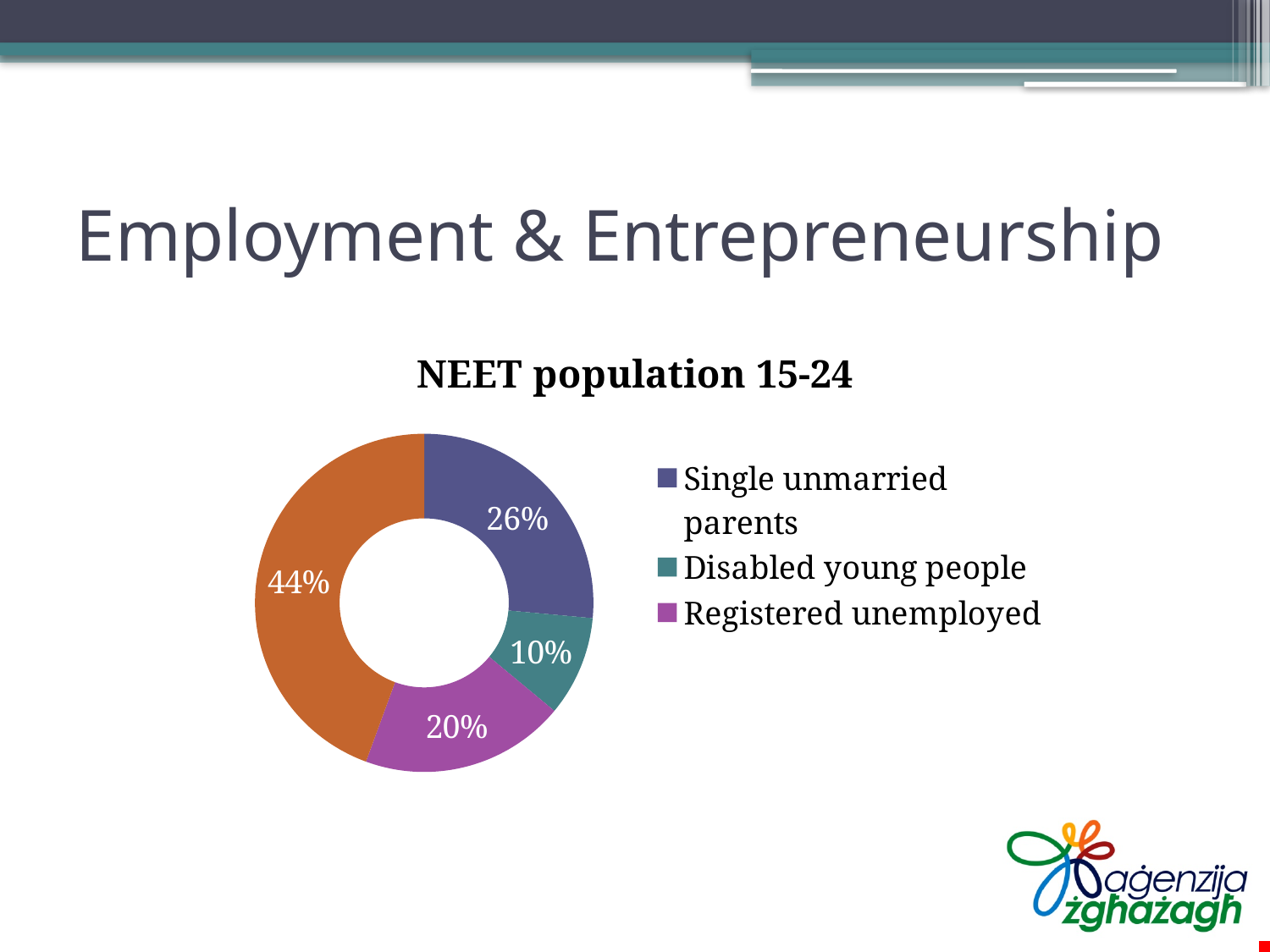
What kind of chart is used to show the NEET population 15-24? Doughnut chart How many entries does the legend of the NEET population 15-24 chart list? 3 What percentage of the NEET population 15-24 is Registered unemployed? 20% Which is larger in the NEET population 15-24 chart: Single unmarried parents or Registered unemployed? Single unmarried parents What is the largest percentage shown on the NEET population 15-24 chart? 44% What percentage of the NEET population 15-24 is Single unmarried parents? 26% What is the title of the chart on the slide? NEET population 15-24 By how many percentage points does Single unmarried parents exceed Registered unemployed in the NEET population 15-24 chart? 6 percentage points By how many percentage points does Registered unemployed exceed Disabled young people in the NEET population 15-24 chart? 10 percentage points What percentage of the NEET population 15-24 is Disabled young people? 10% Which legend category has the smallest share of the NEET population 15-24? Disabled young people How many slices does the NEET population 15-24 chart have? 4